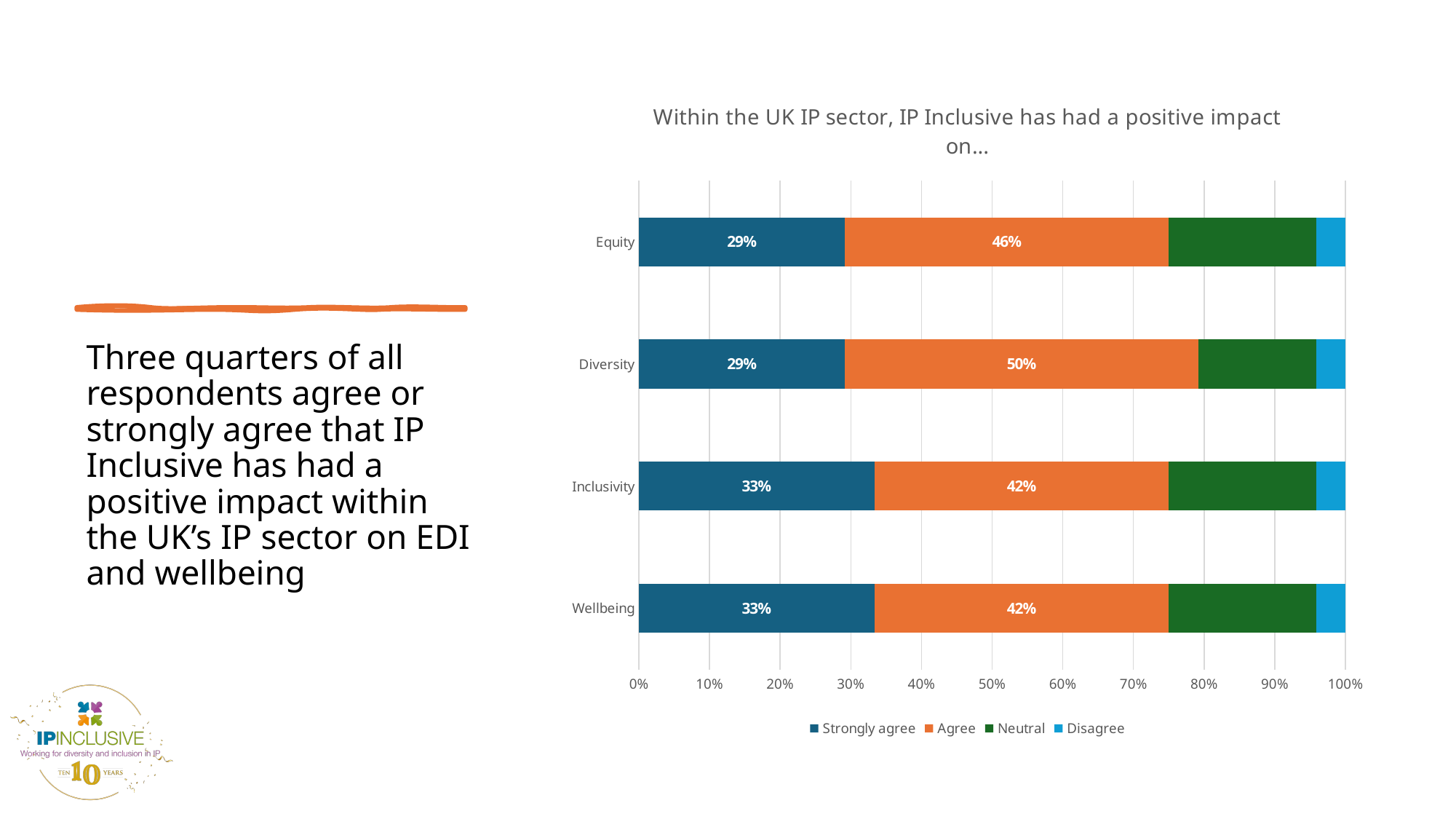
How many categories are shown on the chart? 4 What is the Agree value for Diversity? 50% Is the Disagree value for Wellbeing greater or less than 10%? less What is the combined Strongly agree and Agree value for Equity? 75% Which has a larger Agree value, Equity or Inclusivity? Equity What is the Strongly agree value for Inclusivity? 33% What is the Agree value for Wellbeing? 42% What is the Strongly agree value for Equity? 29% What kind of chart is shown on the slide? Stacked bar chart What is the difference between the Agree values for Diversity and Equity? 4% Which category has the highest Agree value? Diversity How many series does the legend list? 4